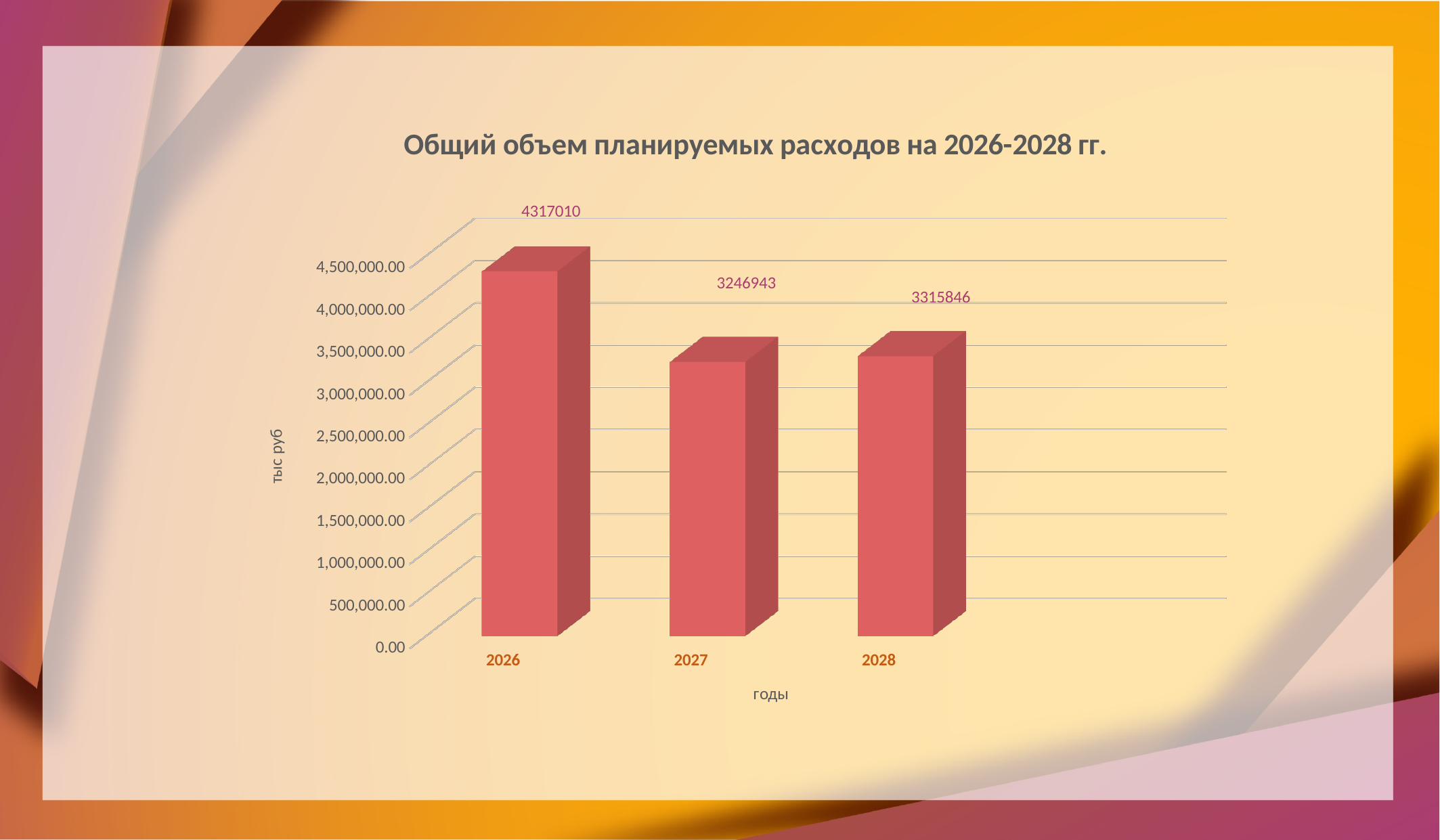
What is the title of the chart? Общий объем планируемых расходов на 2026-2028 гг. What is the value for 2027? 3246943 Which is larger, the value for 2026 or the value for 2028? 2026 What is the difference between the values for 2028 and 2027? 68903 How many years are shown on the x axis? 3 What is the difference between the values for 2026 and 2027? 1070067 Is the value for 2027 greater or less than 3,500,000.00? less Which year has the highest planned expenditure? 2026 What is the value for 2026? 4317010 Which year has the lowest planned expenditure? 2027 What kind of chart is shown on the slide? bar chart What is the value for 2028? 3315846